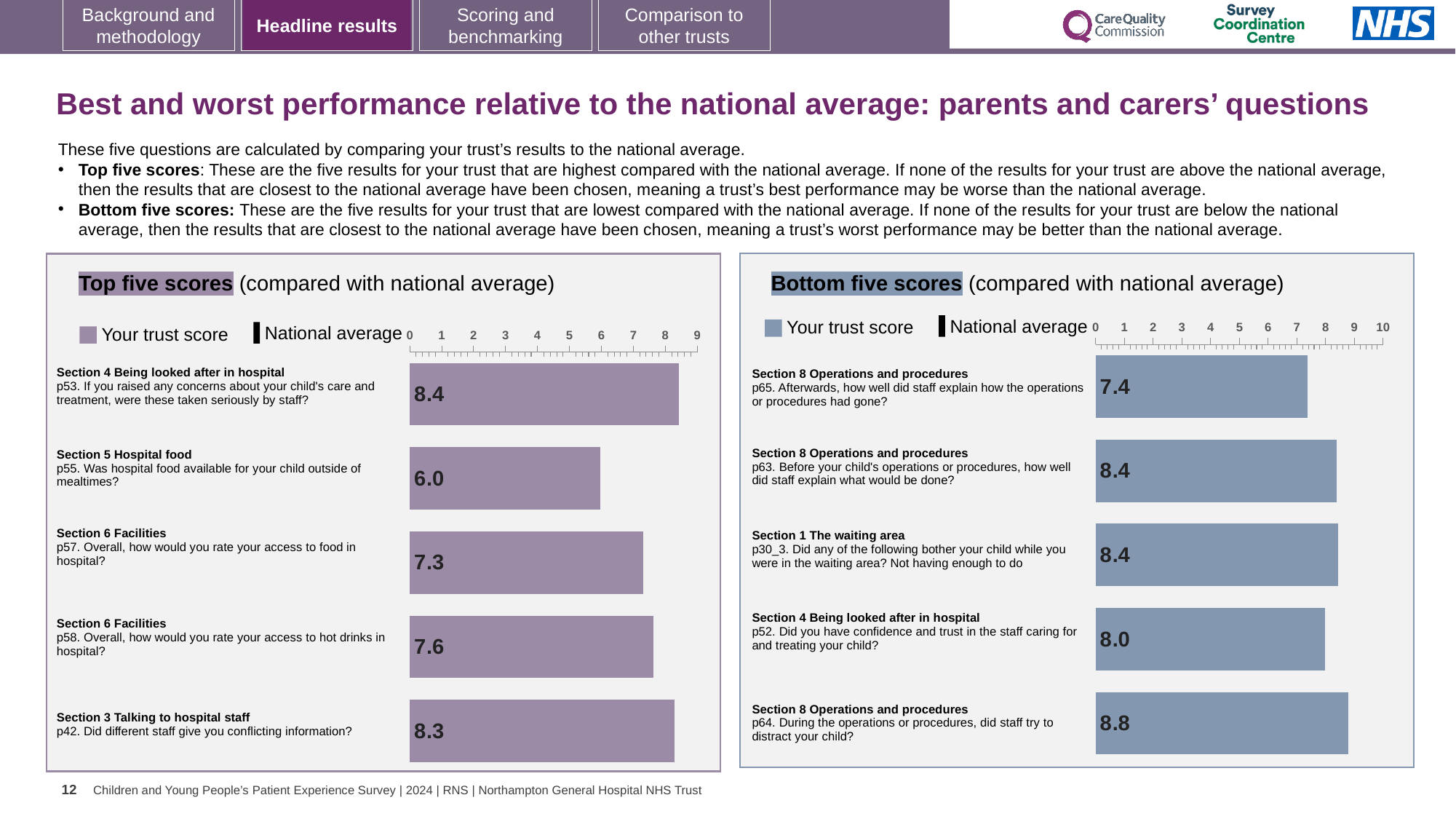
What kind of chart is the 'Top five scores' chart? Bar chart In the 'Bottom five scores' chart, which question has the highest trust score? p64. During the operations or procedures, did staff try to distract your child? In the 'Bottom five scores' chart, what is the trust score for p52 (Did you have confidence and trust in the staff caring for and treating your child?)? 8.0 In the 'Bottom five scores' chart, what is the difference between the trust scores for p64 and p65? 1.4 In the 'Top five scores' chart, what is the trust score for p53 (If you raised any concerns about your child's care and treatment, were these taken seriously by staff?)? 8.4 In the 'Top five scores' chart, which has the larger trust score: p57 (access to food) or p58 (access to hot drinks)? p58 (access to hot drinks) In the 'Top five scores' chart, is the trust score for p55 greater or less than 7? less In the 'Bottom five scores' chart, is the trust score for p64 greater or less than 8? greater In the 'Top five scores' chart, what is the difference between the trust scores for p53 and p55? 2.4 How many questions are plotted in the 'Bottom five scores' chart? 5 In the 'Top five scores' chart, which question has the lowest trust score? p55. Was hospital food available for your child outside of mealtimes? How many entries does the legend of the 'Bottom five scores' chart list? 2